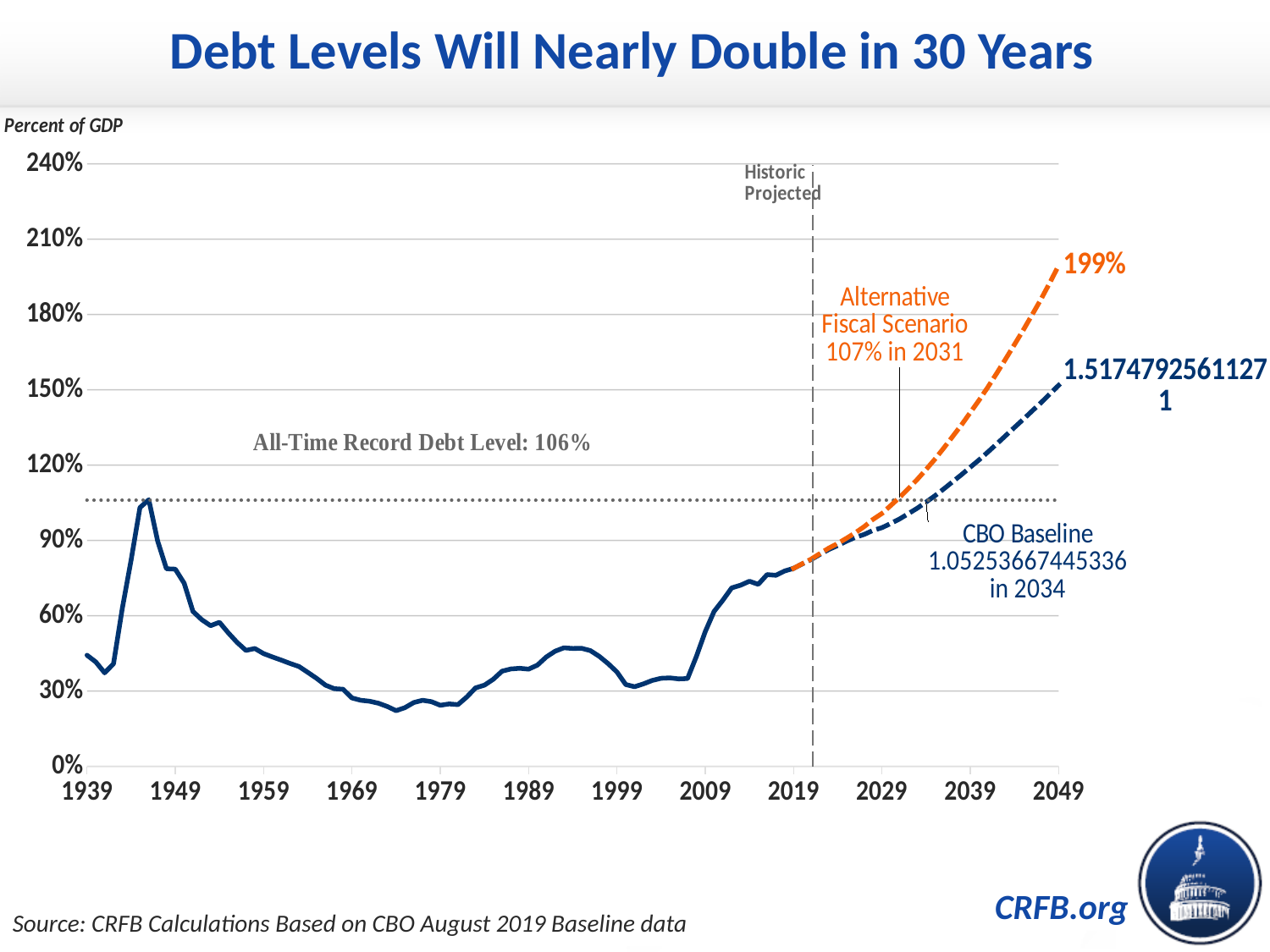
What is the title of the chart? Debt Levels Will Nearly Double in 30 Years What value does the CBO Baseline reach in 2034, according to the annotation? 1.05253667445336 Is the debt level in 1939 greater or less than 60%? less What is the all-time record debt level shown by the dotted horizontal line? 106% Is the peak debt level in the mid-1940s greater or less than 90%? greater What value does the Alternative Fiscal Scenario reach in 2031, according to the annotation? 107% Which projection is higher in 2049, the Alternative Fiscal Scenario or the CBO Baseline? Alternative Fiscal Scenario What value does the Alternative Fiscal Scenario line reach at the end of the projection in 2049? 199% What value is labelled at the end of the CBO Baseline line in 2049? 1.51747925611271 What unit is the vertical axis measured in, according to the axis label? Percent of GDP What kind of chart is shown on the slide? line chart Does the debt level rise or fall between the mid-1940s peak and the mid-1970s? fall